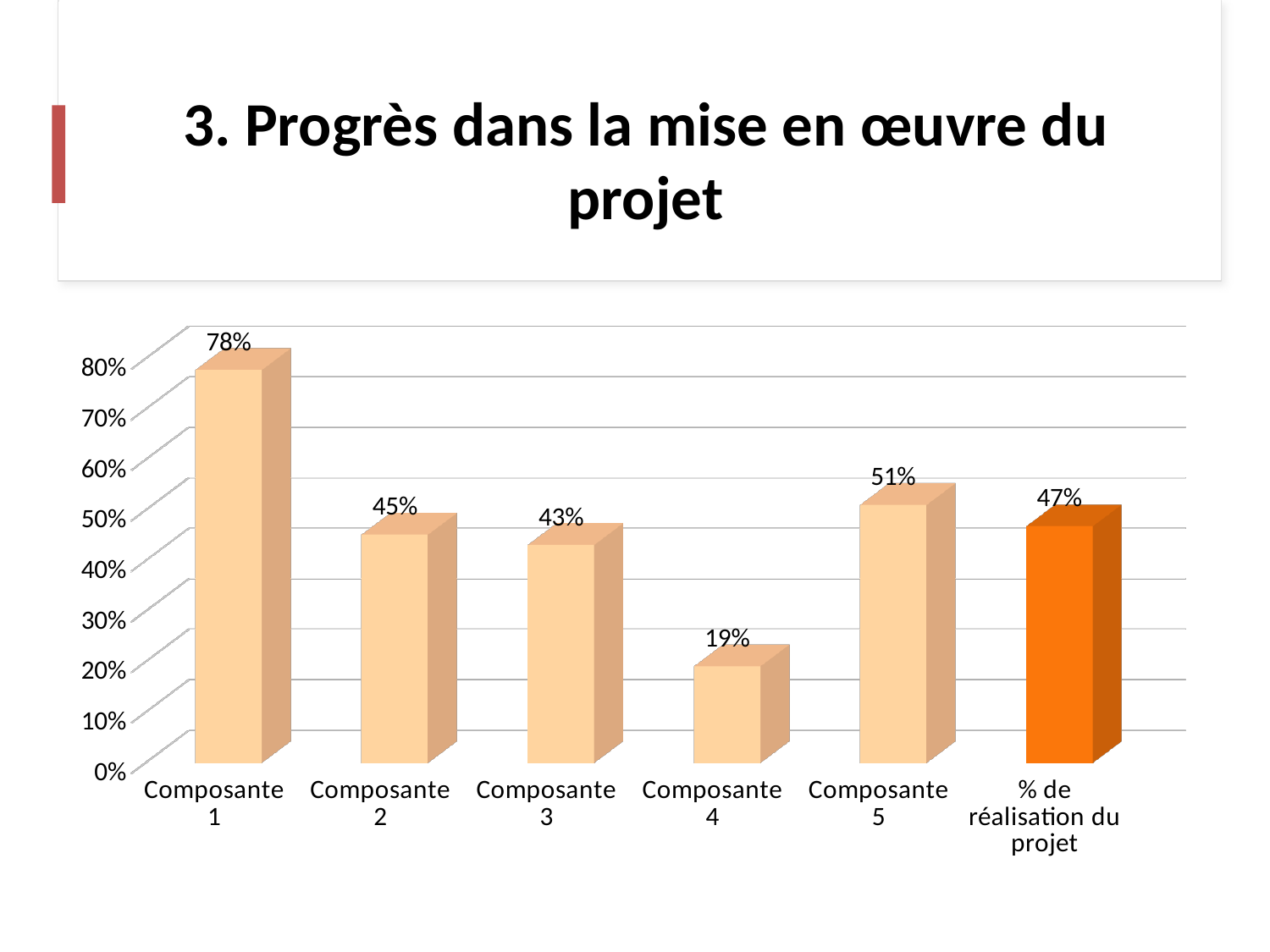
What is the value for % de réalisation du projet? 47% What is the difference between the values for Composante 2 and Composante 3? 2% What is the value for Composante 4? 19% What is the value for Composante 1? 78% How many categories are shown on the x axis? 6 What kind of chart is shown on the slide? bar chart Which is larger, the value for Composante 5 or the value for % de réalisation du projet? Composante 5 Which category has the lowest value? Composante 4 Which category has the highest value? Composante 1 Which bar is shown in a darker orange colour than the others? % de réalisation du projet Is the value for Composante 3 greater or less than 40%? greater What is the difference between the values for Composante 1 and Composante 5? 27%